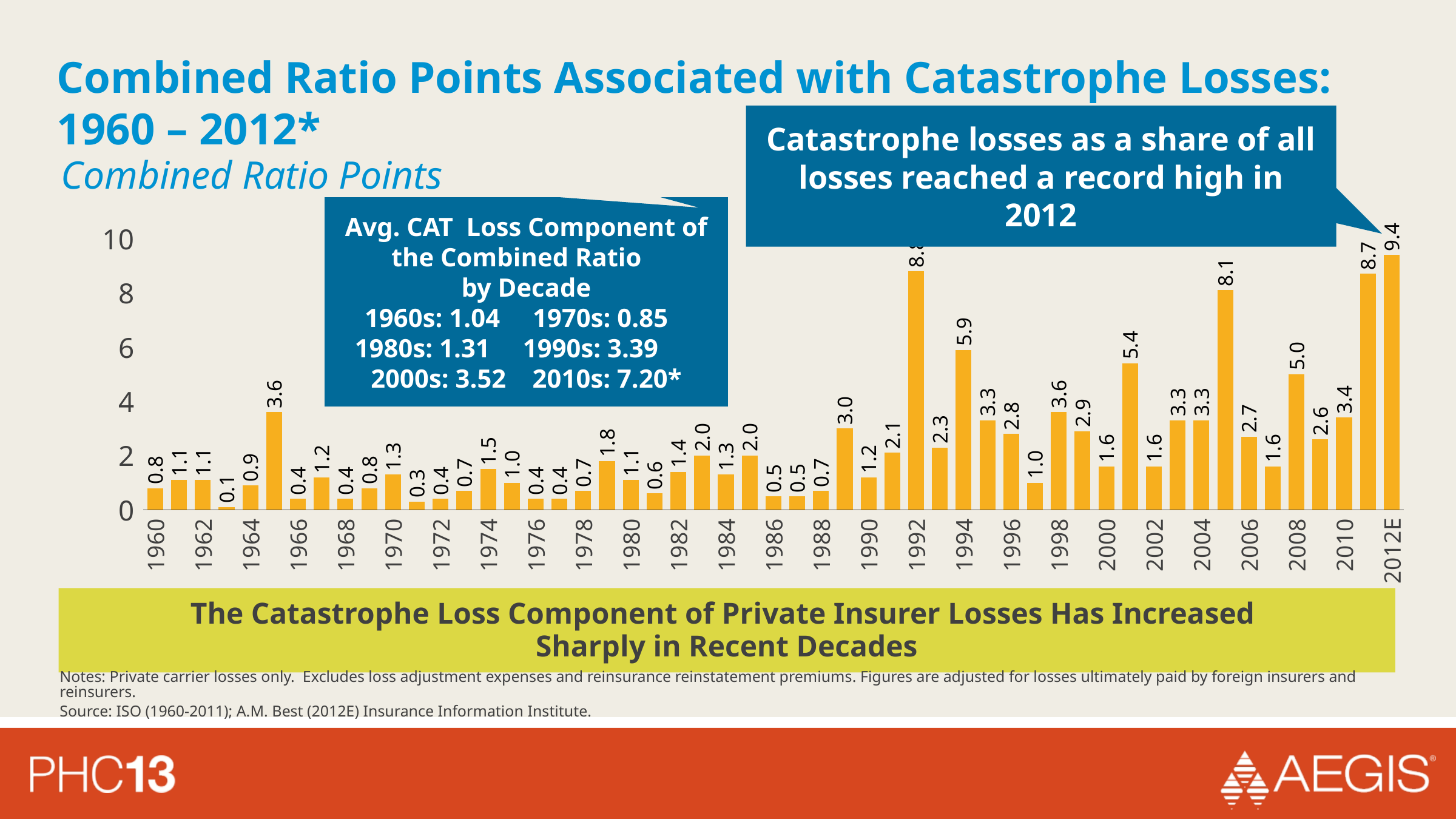
What is the difference between the values for 2004 and 2006? 0.6 What is the value for 1994? 5.9 Do the values generally rise or fall from 1960 to 2012E? rise What is the value for 1966? 0.4 Which year has the highest value? 2012E Is the value for 1992 greater or less than 8? greater What is the value for 2008? 5.0 What is the difference between the values for 2012E and 2010? 6.0 What is the value for 2012E? 9.4 Which is larger, the value for 1998 or the value for 2000? 1998 According to the callout box, what is the average CAT loss component of the combined ratio for the 1990s? 3.39 What kind of chart is shown? bar chart